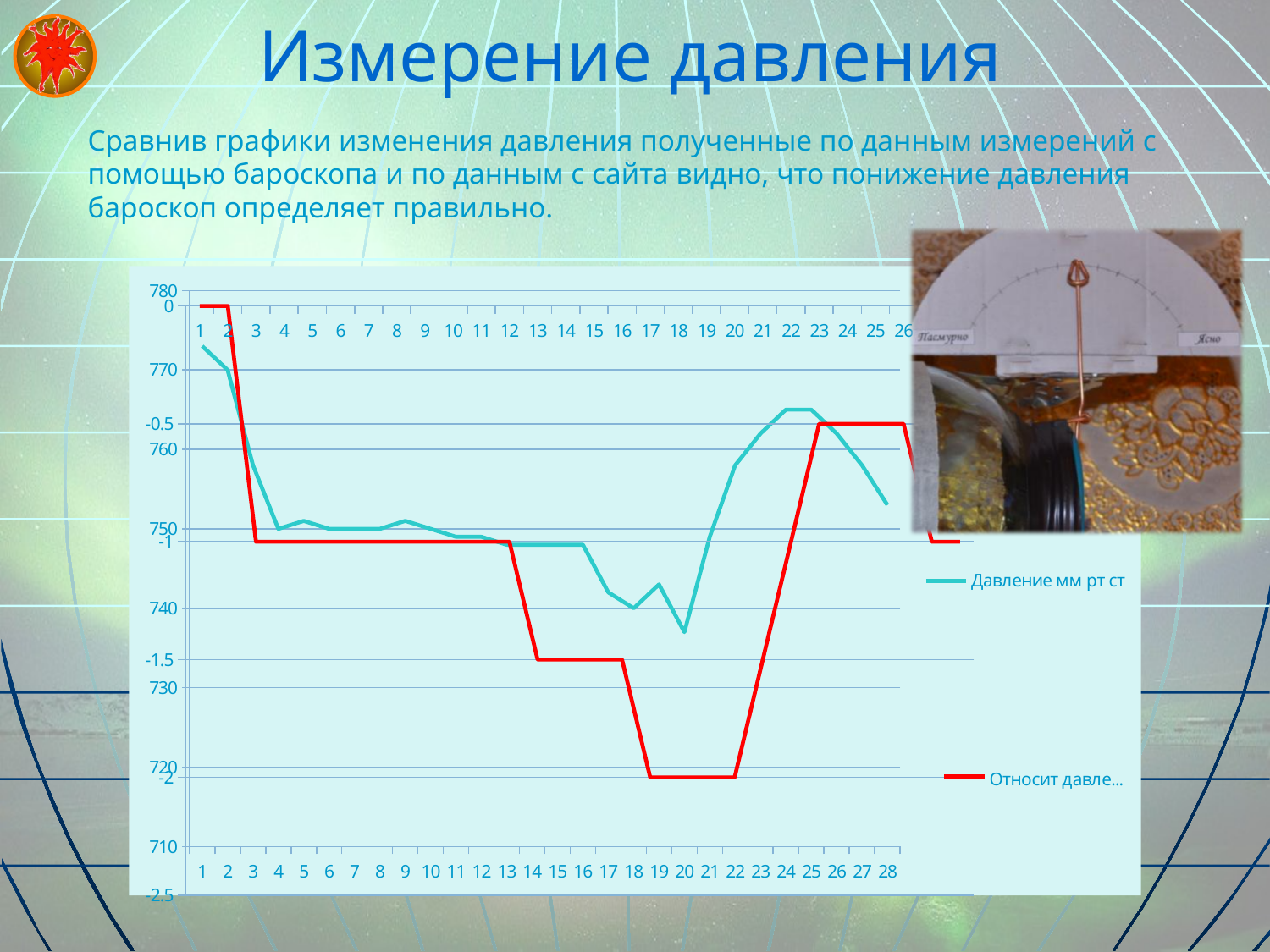
Is the value of the 'Давление мм рт ст' series at point 20 greater or less than 740? less What is the value of the red 'Относит давле...' series at point 26? -0.5 By how much does the red 'Относит давле...' value at point 1 exceed its value at point 20? 2 How many series does the legend list? 2 Does the red 'Относит давле...' series rise or fall from point 1 to point 20? fall What is the value of the red 'Относит давле...' series at point 10? -1 What is the value of the red 'Относит давле...' series at point 16? -1.5 Is the value of the 'Давление мм рт ст' series at point 24 greater or less than 760? greater What is the value of the red 'Относит давле...' series at point 1? 0 How many points are plotted along the x axis for each series? 28 What kind of chart is shown on the slide? line chart What is the value of the red 'Относит давле...' series at point 20? -2